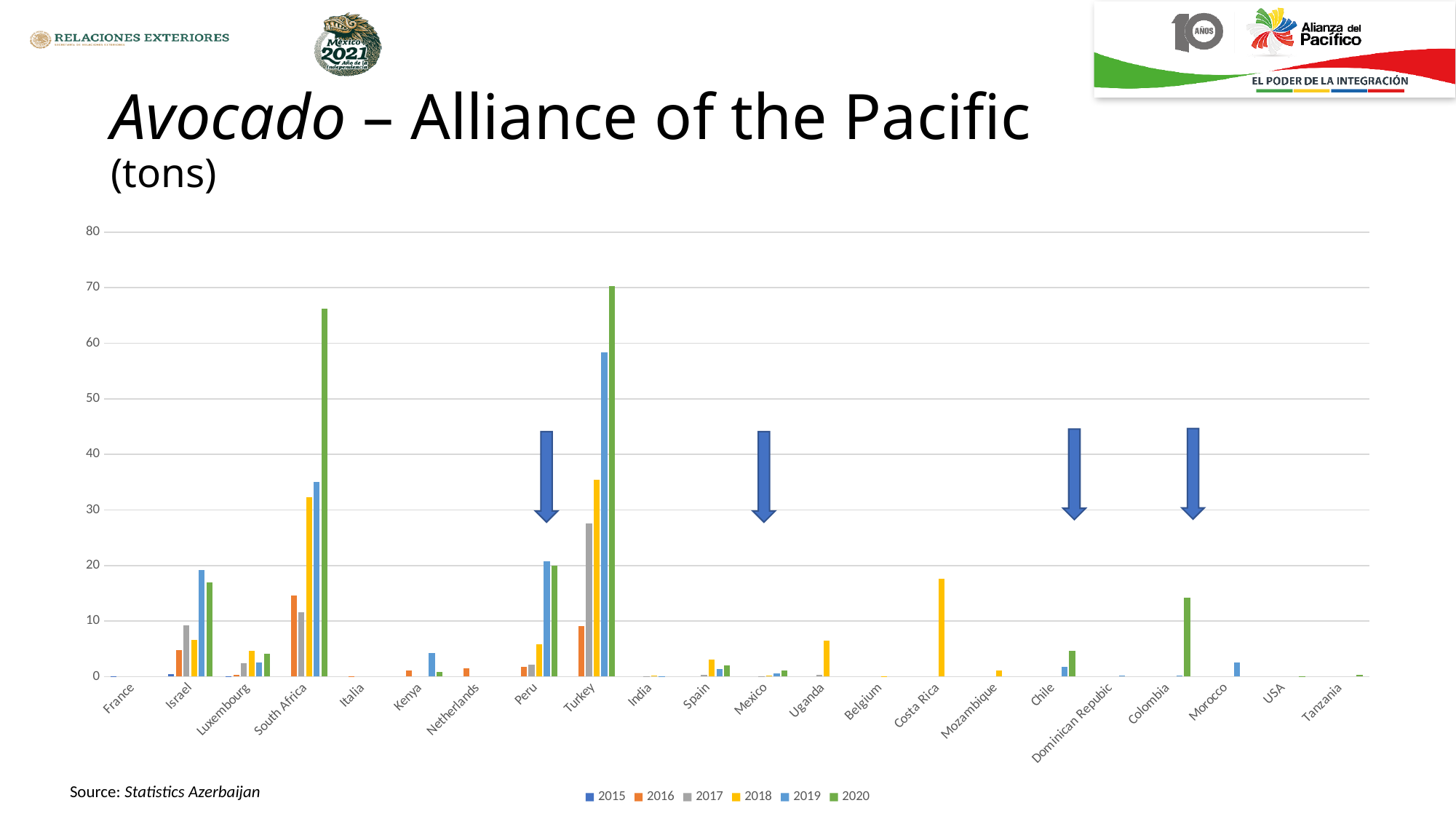
Is the 2018 value for Costa Rica greater or less than 10? greater Which country has the tallest bar in the chart? Turkey Is the 2020 value for Colombia greater or less than 10? greater Which is larger, the 2019 value for Turkey or the 2019 value for South Africa? Turkey Is the 2019 value for Turkey greater or less than 50? greater What kind of chart is shown on the slide? bar chart Which is larger, the 2020 value for Peru or the 2020 value for Mexico? Peru How many series does the legend list? 6 What source is cited for the chart data? Statistics Azerbaijan How many countries are shown on the x axis? 22